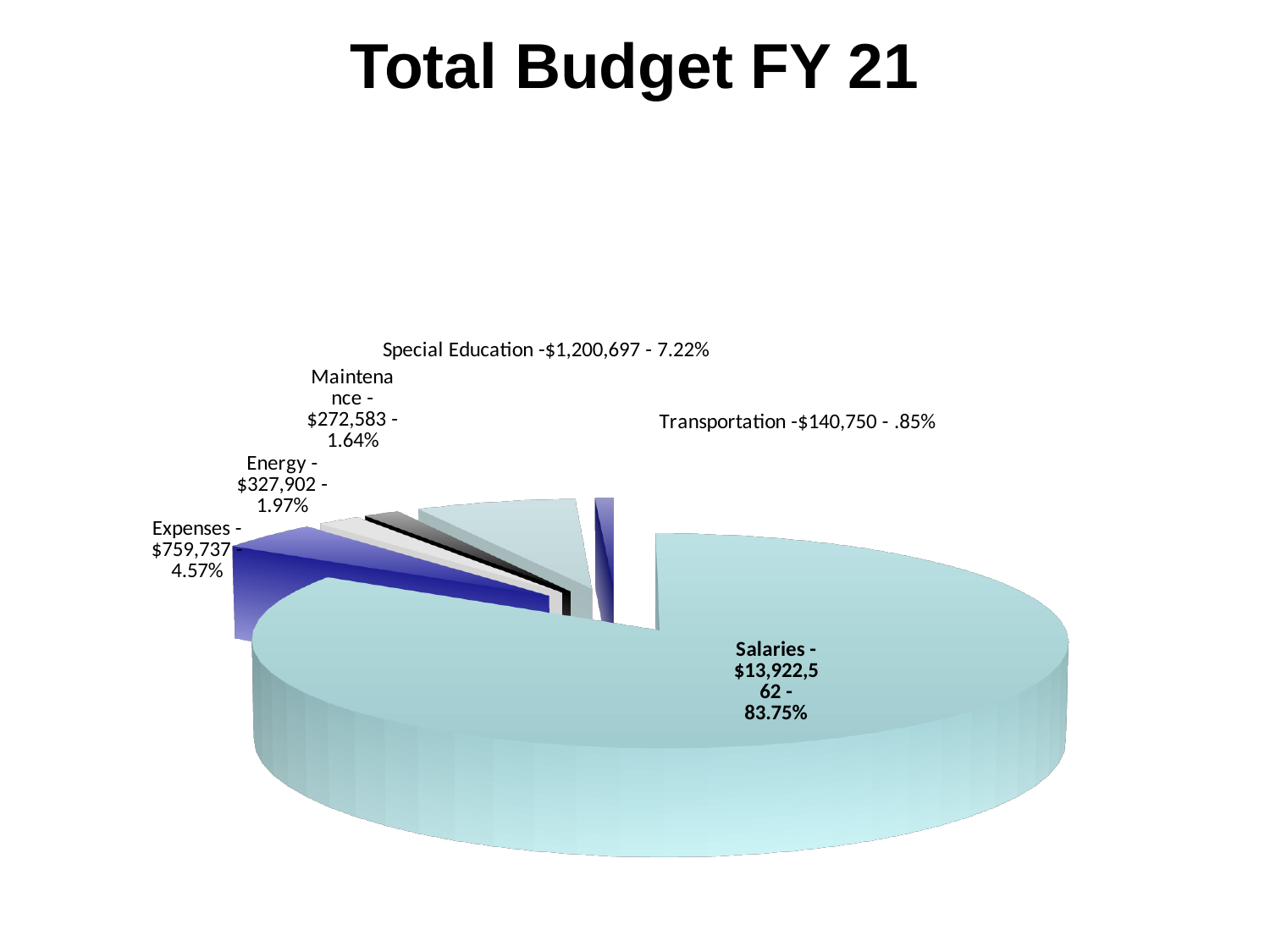
What is the dollar value shown for Salaries? $13,922,562 What percentage of the budget is Special Education? 7.22% What percentage of the budget is Energy? 1.97% What is the difference in dollars between Expenses and Energy? $431,835 Which category has the smallest share of the budget? Transportation What kind of chart is shown on the slide? Pie chart How many slices does the pie chart have? 6 Which category has the largest share of the budget? Salaries What is the dollar value shown for Transportation? $140,750 Which is larger, the Energy value or the Maintenance value? Energy What percentage of the budget is Expenses? 4.57% What is the title of the chart? Total Budget FY 21